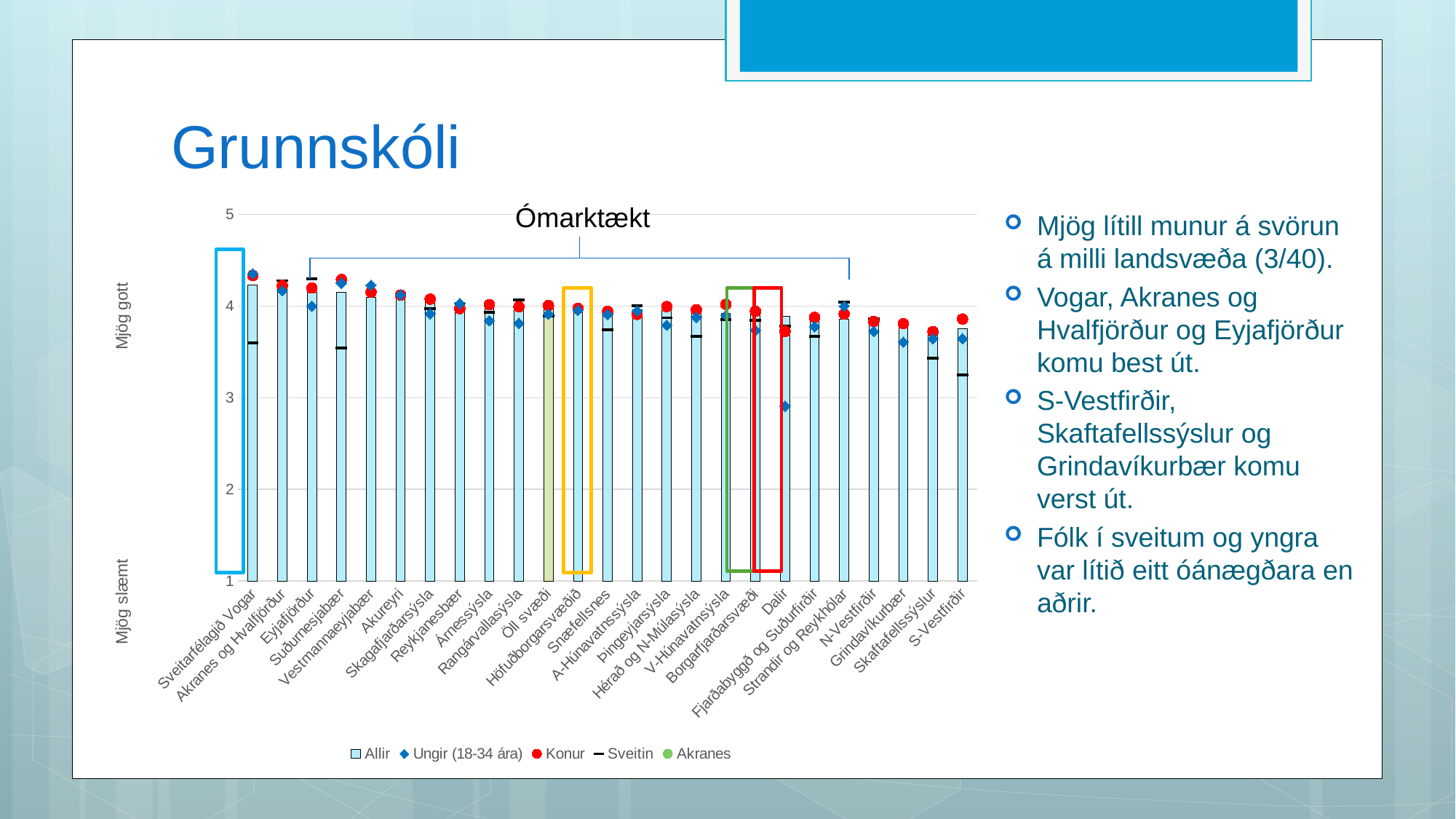
Is the Allir value for S-Vestfirðir greater or less than 4? less What is the title of the slide containing the chart? Grunnskóli Which category has the lowest Ungir (18-34 ára) value? Dalir How many series does the chart legend list? 5 What kind of chart is shown on the slide? bar chart Do the Allir values generally rise or fall from left to right along the x axis? fall Is the Sveitin value for S-Vestfirðir greater or less than 4? less Is the Allir value for Sveitarfélagið Vogar greater or less than 4? greater Which is larger, the Allir value for Sveitarfélagið Vogar or the Allir value for Dalir? Sveitarfélagið Vogar Which category has the lowest Sveitin value? S-Vestfirðir How many categories are shown along the x axis of the chart? 25